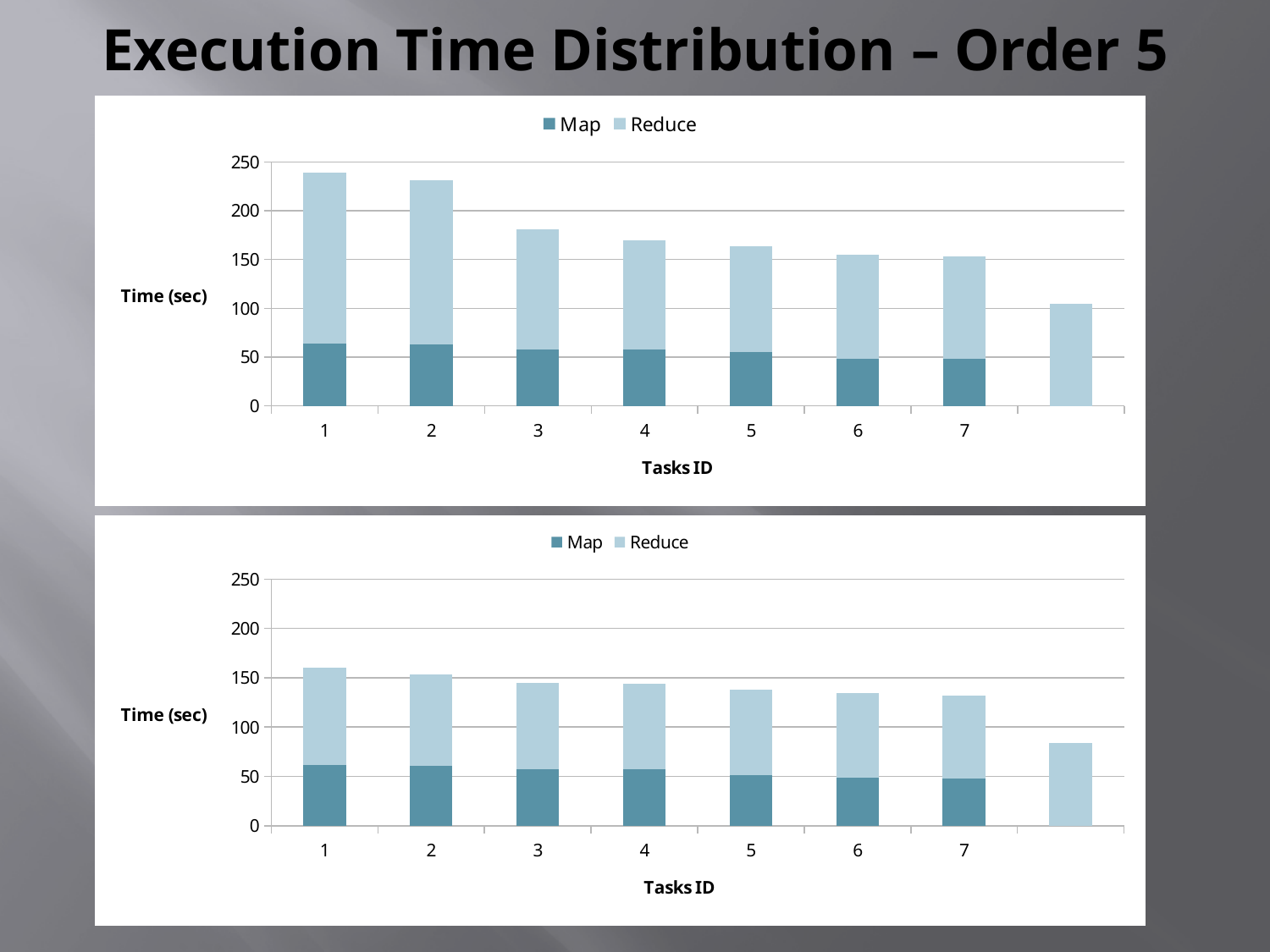
In the top chart, is the total value for task ID 3 greater or less than 200? less In the bottom chart, which labeled task ID has the highest total execution time? 1 What is the y-axis title of the top chart? Time (sec) What kind of chart is the top chart on the slide? Stacked bar chart In the bottom chart, do the total execution times rise or fall as the task ID increases from 1 to 7? Fall In the top chart, is the Map value for task ID 1 greater or less than 50? greater In the top chart, which has the larger total execution time, task ID 1 or task ID 4? Task ID 1 What are the two series named in the legend of the bottom chart? Map and Reduce In the bottom chart, is the total value for task ID 7 greater or less than 150? less In the top chart, which labeled task ID has the highest total execution time? 1 How many series does the legend of the top chart list? 2